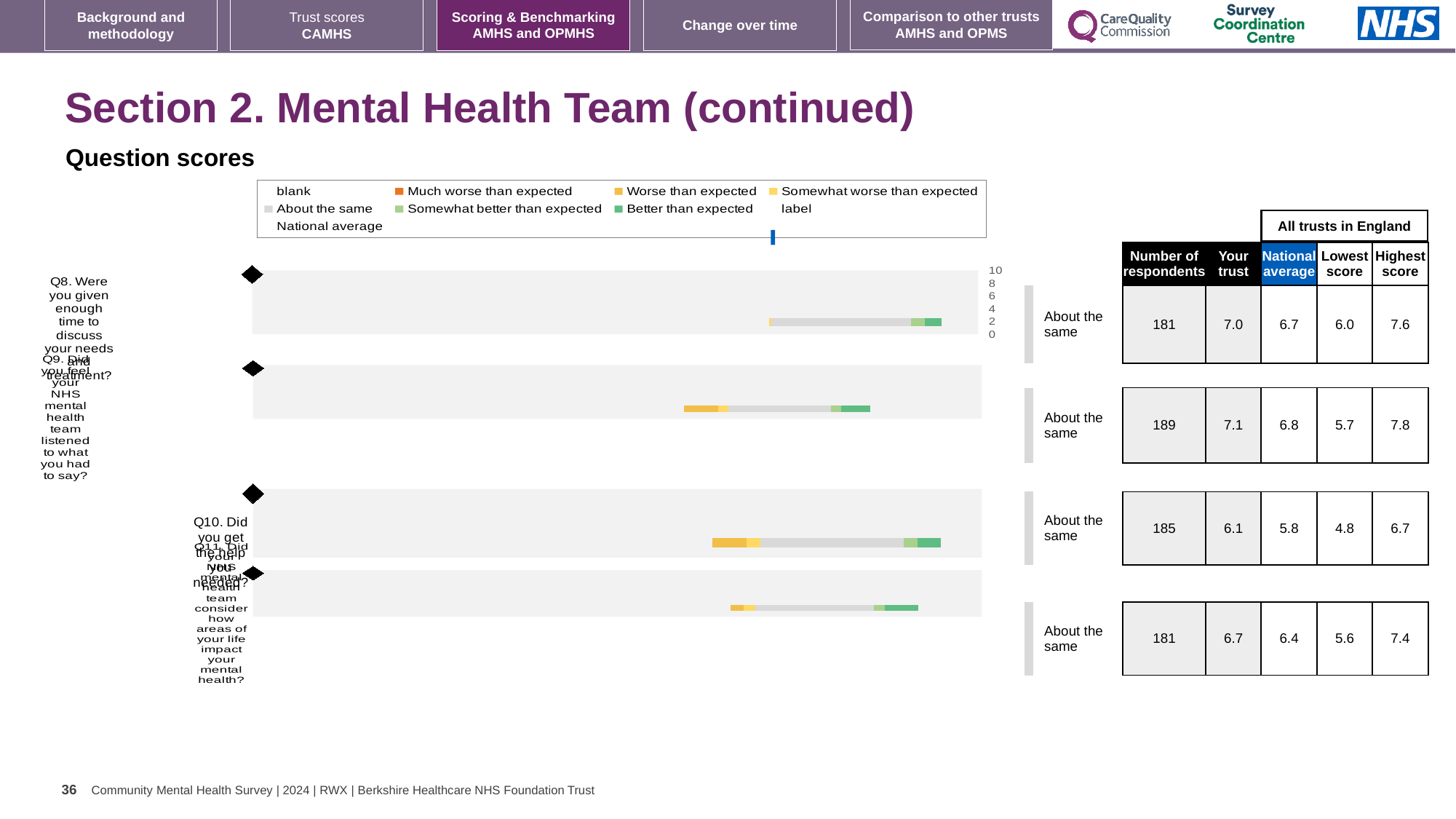
According to the table next to the charts, what is the national average for Q9 (Did you feel your NHS mental health team listened to what you had to say?)? 6.8 Which question has the highest 'Your trust' score in the table next to the charts? Q9 What benchmark category is shown beside each of the four question charts? About the same Which question has the lowest 'Your trust' score in the table next to the charts? Q10 What is the lowest score among all trusts in England for Q10 in the table next to the charts? 4.8 How many questions (Q8 to Q11) have a bar chart on this slide? 4 According to the table next to the charts, what is the 'Your trust' score for Q8 (Were you given enough time to discuss your needs and treatment?)? 7.0 According to the table next to the charts, what is the highest score among all trusts in England for Q11? 7.4 Which has the larger 'Your trust' score, Q8 or Q11? Q8 What is the difference between the 'Your trust' score and the national average for Q9? 0.3 What kind of chart is used to show the question scores on this slide? bar chart According to the table next to the charts, how many respondents answered Q10 (Did you get the help you needed?)? 185